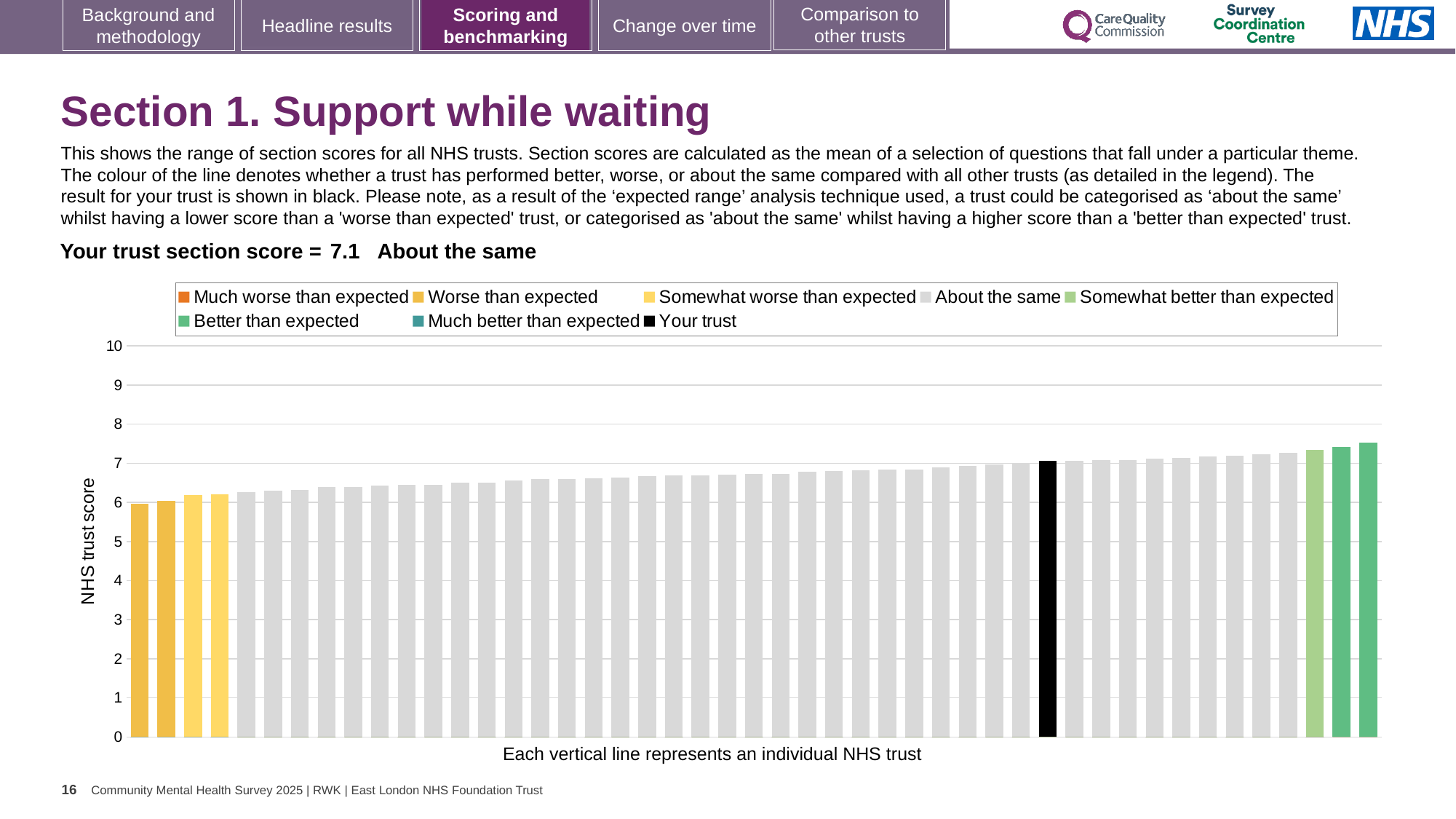
How many bars are coloured as 'Worse than expected' (orange-gold)? 2 What is the section score for your trust shown on the slide? 7.1 Is the value of the leftmost (lowest) bar greater or less than 5? greater How many bars are coloured as 'Somewhat better than expected' (light green)? 1 How many bars are coloured as 'Better than expected' (dark green)? 2 Is the black 'Your trust' bar higher or lower than the rightmost bar? lower What kind of chart is shown on the slide? bar chart Is the value of the rightmost (highest) bar greater or less than 8? less Do the bar values rise or fall from left to right along the x axis? rise How many entries does the chart legend list? 8 Which category is your trust placed in for this section? About the same